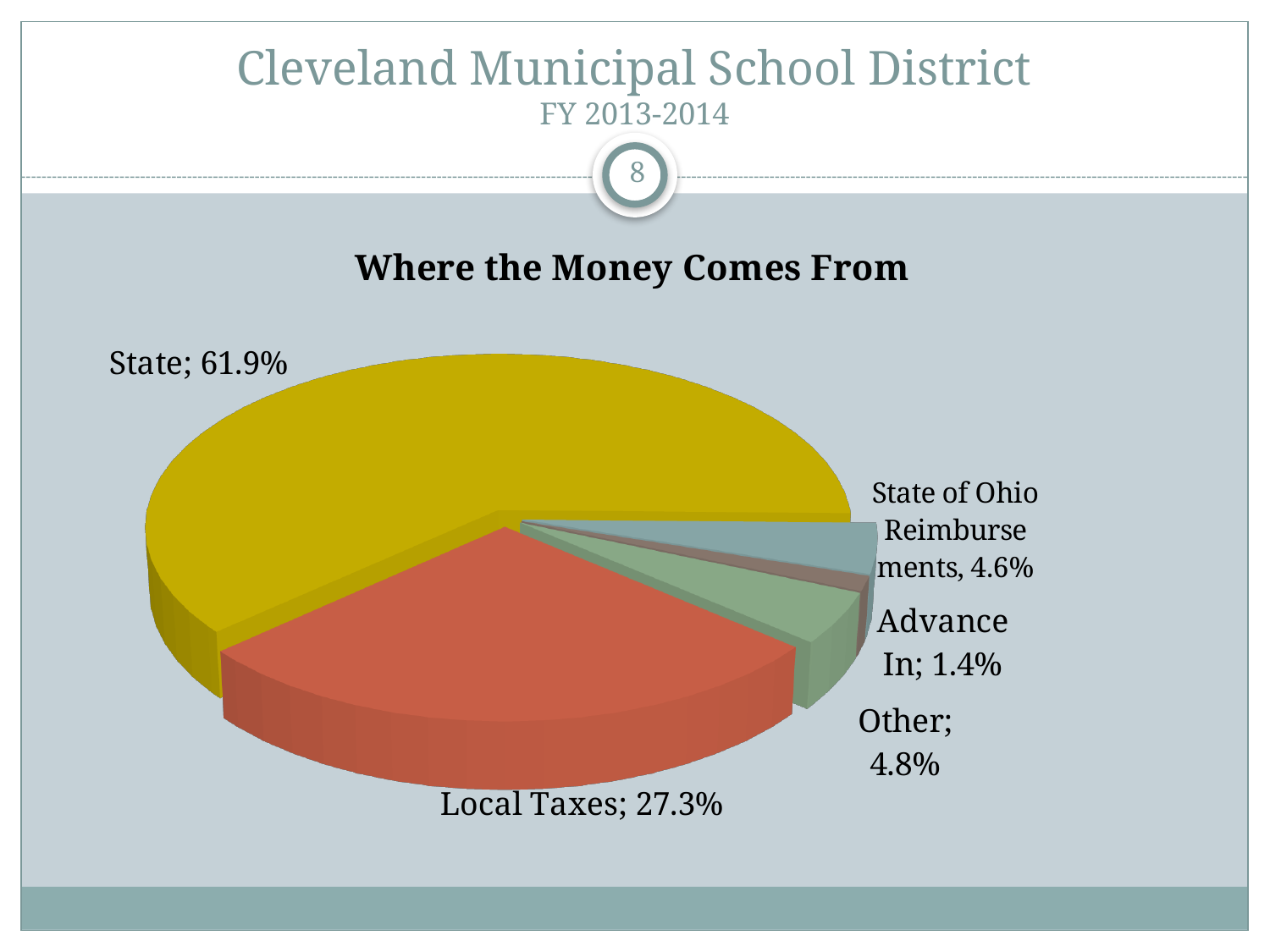
What is the value shown for State of Ohio Reimbursements? 4.6% What is the value shown for Local Taxes? 27.3% What is the title of the chart? Where the Money Comes From Which category has the smallest slice of the pie? Advance In Which is larger, Other or State of Ohio Reimbursements? Other Which category has the largest slice of the pie? State How many categories are shown in the pie chart? 5 What kind of chart is shown on the slide? Pie chart What is the value shown for Advance In? 1.4% What is the value shown for Other? 4.8% What is the difference between the State and Local Taxes shares? 34.6% What share of the pie does State account for? 61.9%